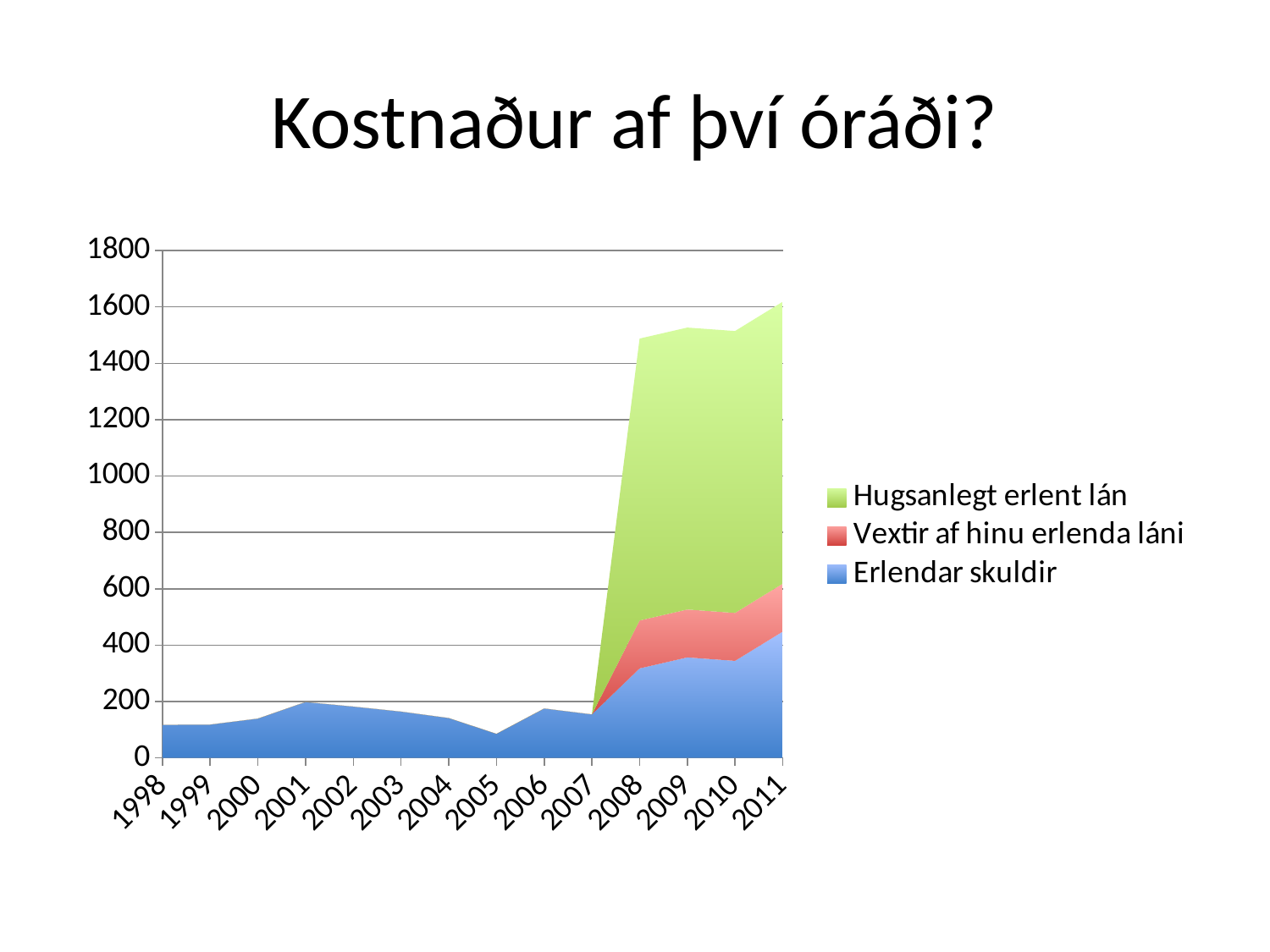
What kind of chart is shown on the slide? Area chart Is the value for Erlendar skuldir in 2011 greater or less than 400? greater Is the value for Erlendar skuldir in 2005 greater or less than 200? less Is the stacked total in 2008 greater or less than 1200? greater What is the title of the chart? Kostnaður af því óráði? How many series does the legend list? 3 In which year is the value for Erlendar skuldir lowest? 2005 Which series is shown in green? Hugsanlegt erlent lán How many years are shown on the x axis? 14 Which is larger, the stacked total in 2007 or the stacked total in 2008? 2008 In which year is the value for Erlendar skuldir highest? 2011